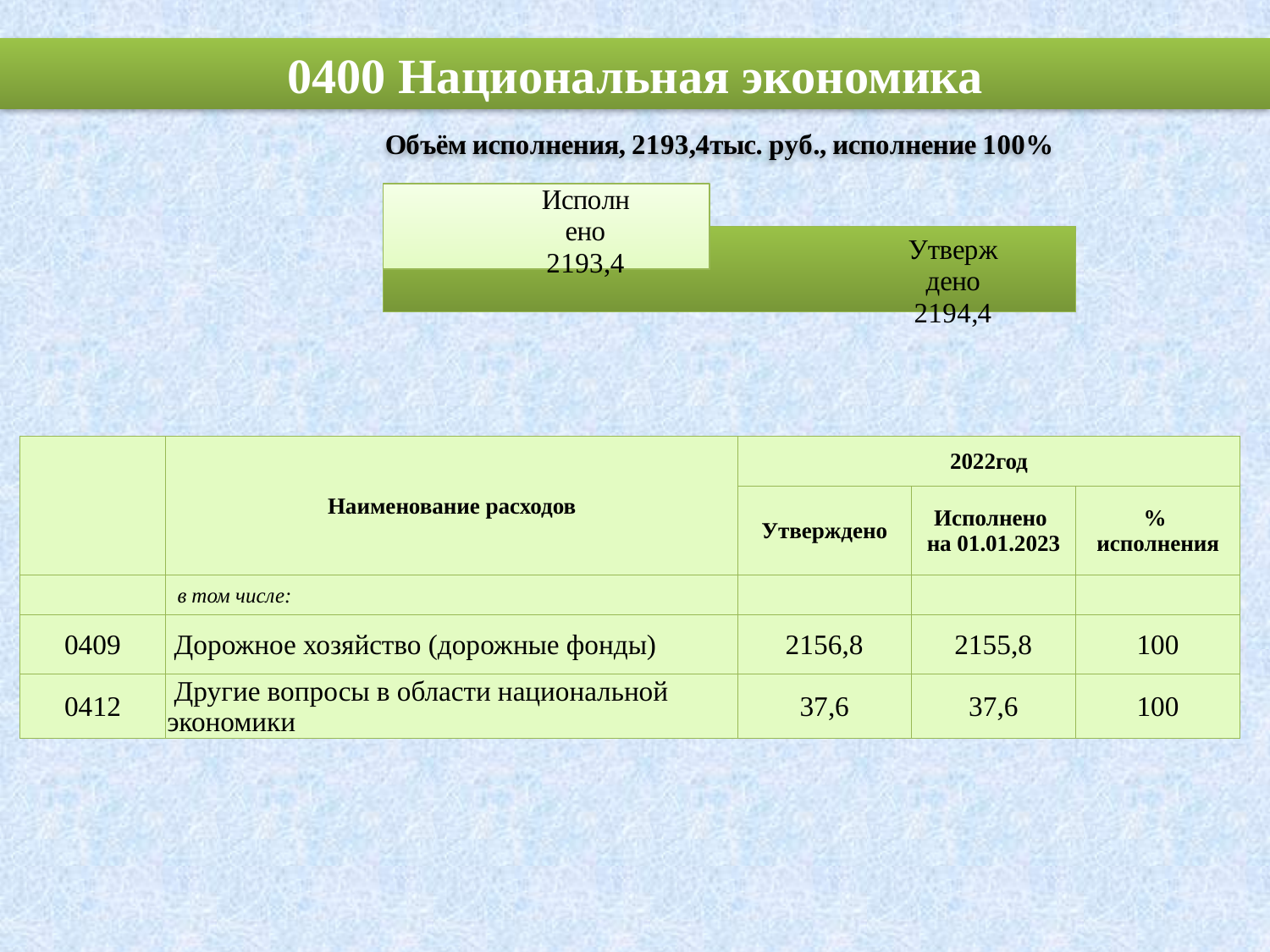
Which category in the chart has the highest value? Утверждено What is the value shown for Утверждено in the chart? 2194,4 Which bar has the higher value, Исполнено or Утверждено? Утверждено What is the difference between the Утверждено value and the Исполнено value in the chart? 1,0 Which bar in the chart is drawn in the darker green colour? Утверждено How many bars does the chart show? 2 What kind of chart is shown on the slide? bar chart What is the value shown for Исполнено in the chart? 2193,4 Which category in the chart has the lowest value? Исполнено What are the labels of the two bars in the chart? Исполнено and Утверждено